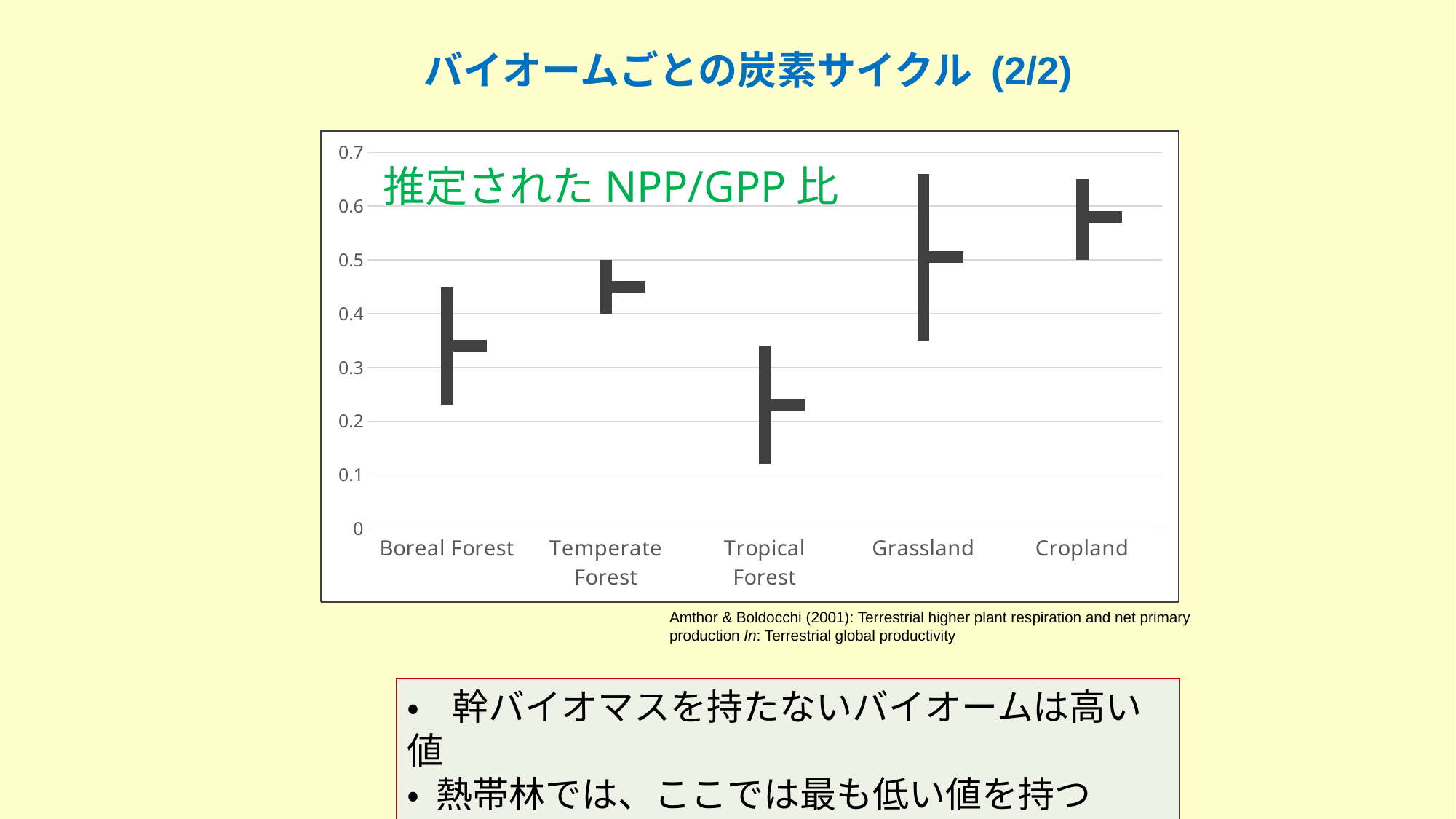
Is the central marker value for Cropland greater or less than 0.5? greater Is the top of the range for Grassland greater or less than 0.6? greater How many biome categories are shown on the x axis of the chart? 5 Which has the higher central marker value, Temperate Forest or Boreal Forest? Temperate Forest Is the central marker value for Tropical Forest greater or less than 0.3? less What is the green text label written inside the chart area? 推定された NPP/GPP 比 What is the highest value shown on the y axis of the chart? 0.7 Which category has the highest central marker value in the chart? Cropland Which category has the lowest central marker value in the chart? Tropical Forest